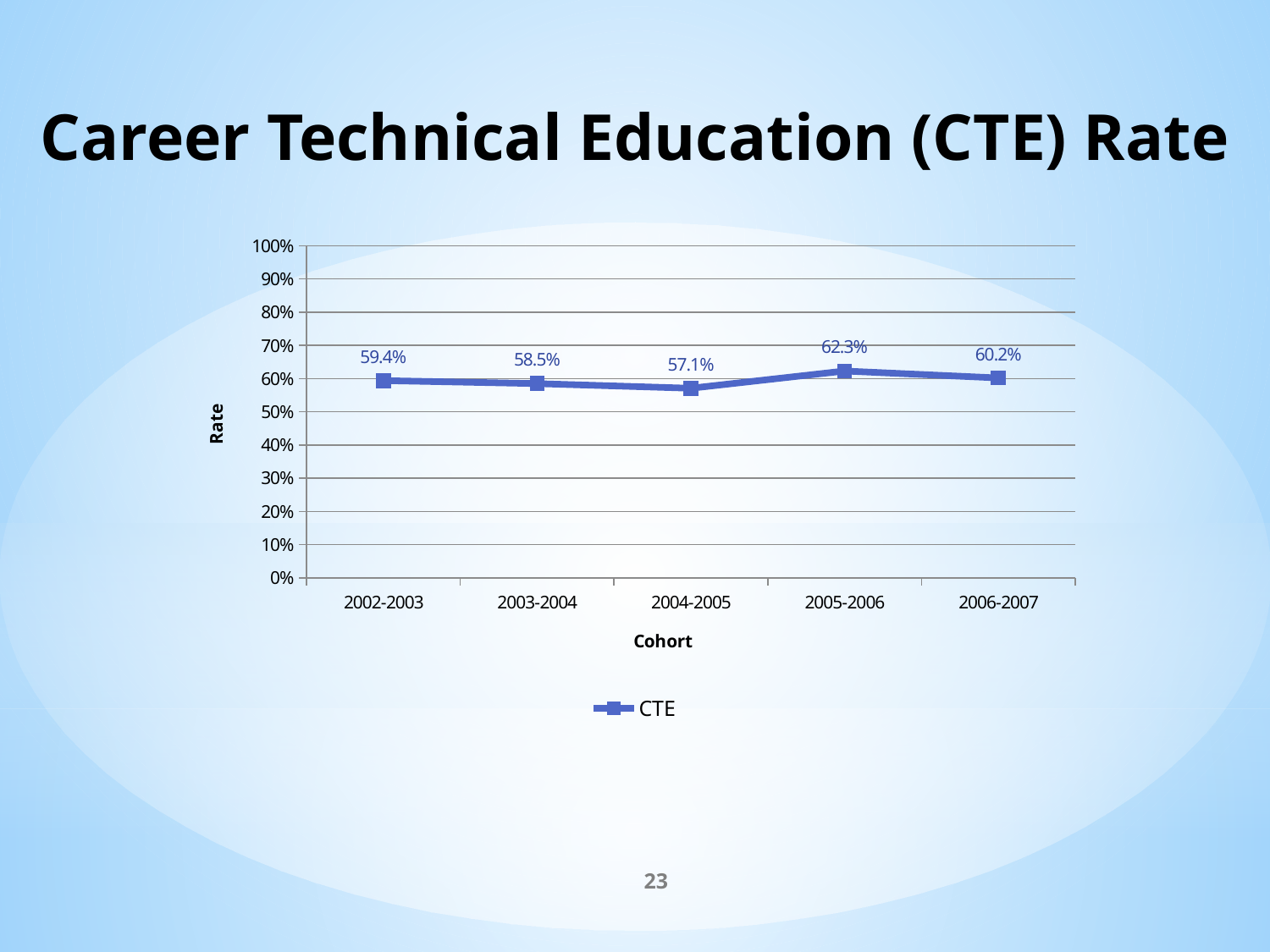
What is the CTE rate for the 2006-2007 cohort? 60.2% How many series does the legend list? 1 What kind of chart is shown on the slide? line chart What is the CTE rate for the 2002-2003 cohort? 59.4% Which cohort has a higher CTE rate, 2003-2004 or 2006-2007? 2006-2007 Which cohort has the highest CTE rate? 2005-2006 What is the CTE rate for the 2004-2005 cohort? 57.1% How many cohorts are plotted on the chart? 5 What is the label of the x axis? Cohort What is the difference between the CTE rate for 2005-2006 and 2004-2005? 5.2% Is the CTE rate for the 2005-2006 cohort greater or less than 70%? less Which cohort has the lowest CTE rate? 2004-2005